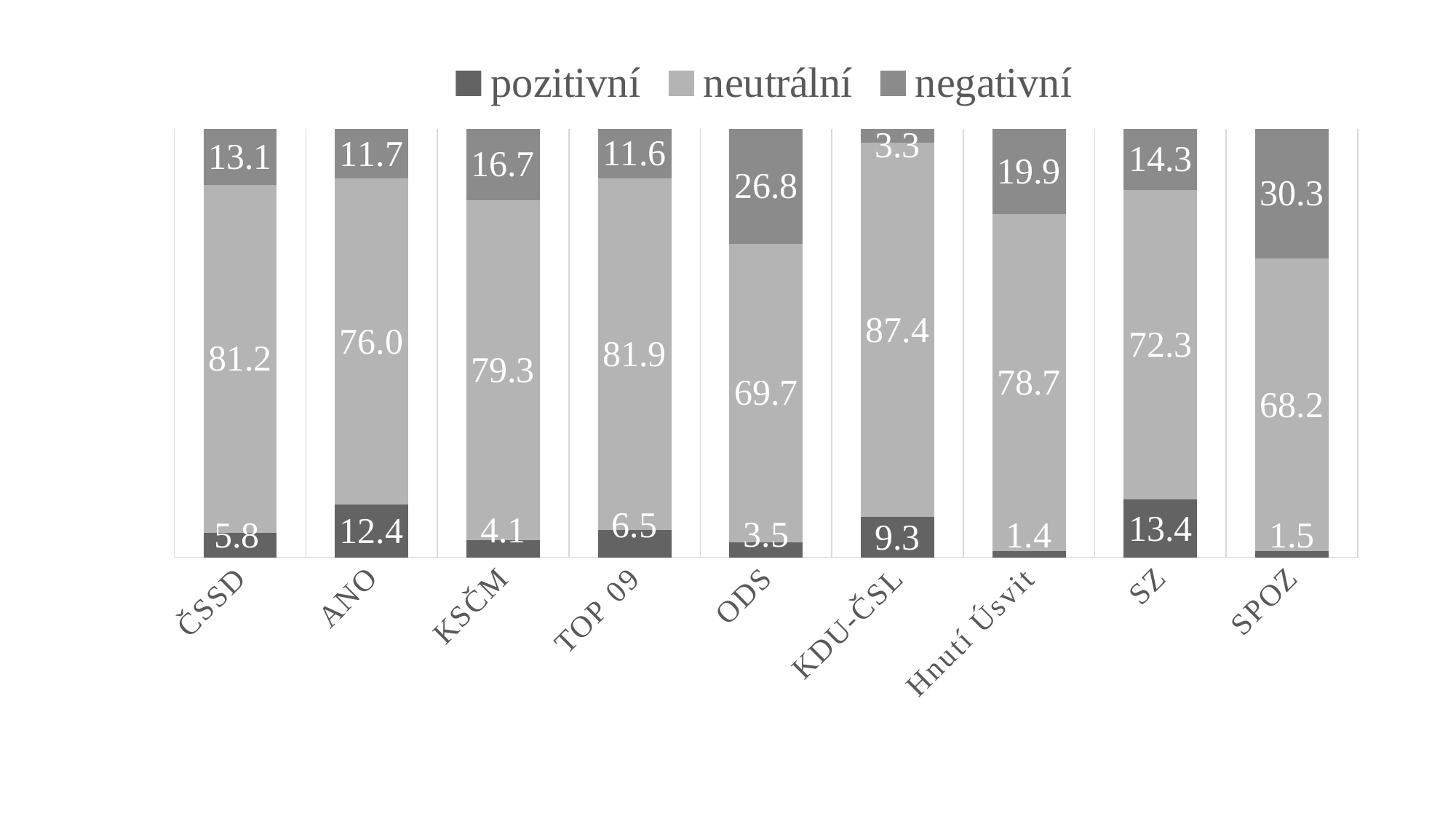
What is the neutrální value for KDU-ČSL? 87.4 Which party has the highest neutrální value? KDU-ČSL Which party has the highest negativní value? SPOZ Which party has the lowest pozitivní value? Hnutí Úsvit How many series does the legend list? 3 How many parties are shown on the x axis? 9 What kind of chart is this? Stacked bar chart Which party has the lowest negativní value? KDU-ČSL What is the pozitivní value for ANO? 12.4 What is the negativní value for ODS? 26.8 Which has a larger neutrální value, ANO or SZ? ANO What is the difference between the negativní values for ODS and ČSSD? 13.7